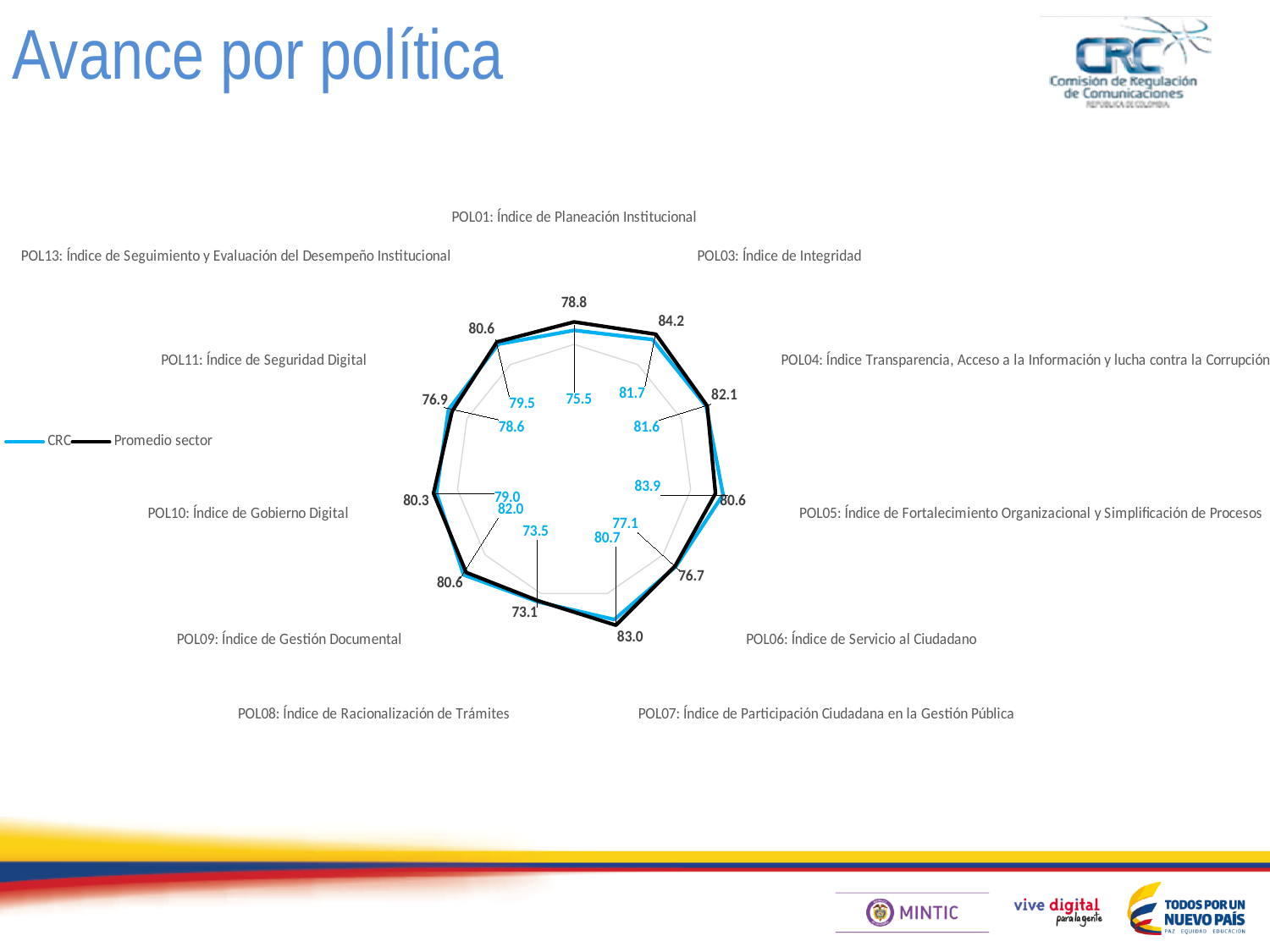
Which series is drawn in blue in the chart? CRC What kind of chart is shown on the slide? Radar chart For POL03: Índice de Integridad, which is larger, the CRC value or the Promedio sector value? Promedio sector What is the CRC value for POL01: Índice de Planeación Institucional? 75.5 What is the difference between the Promedio sector and CRC values for POL01: Índice de Planeación Institucional? 3.3 Which policy has the highest Promedio sector value? POL03: Índice de Integridad What is the CRC value for POL05: Índice de Fortalecimiento Organizacional y Simplificación de Procesos? 83.9 What is the Promedio sector value for POL01: Índice de Planeación Institucional? 78.8 Which policy has the lowest Promedio sector value? POL08: Índice de Racionalización de Trámites What is the Promedio sector value for POL03: Índice de Integridad? 84.2 How many policy categories (axes) does the radar chart have? 11 How many series does the legend list? 2